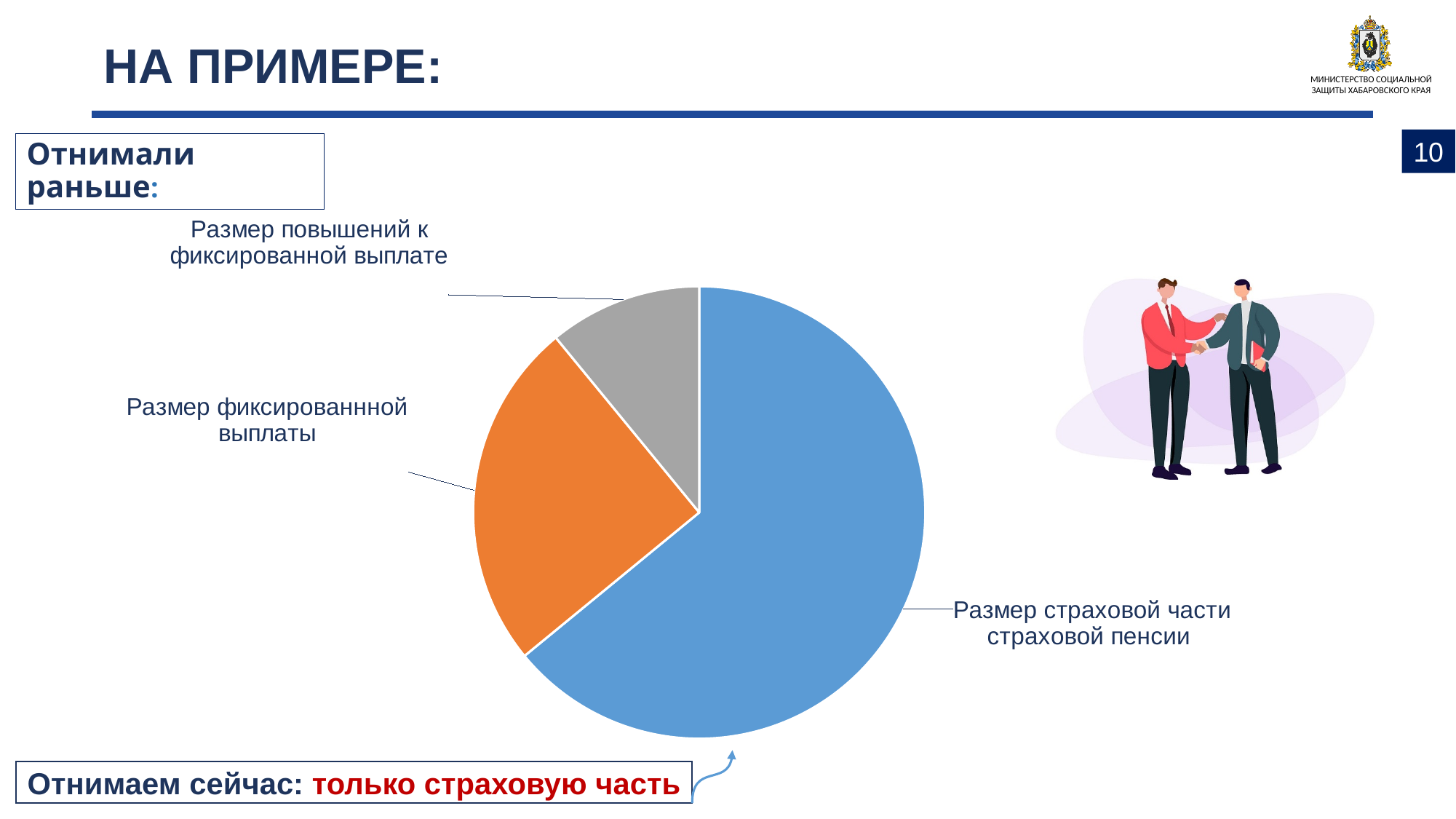
How many slices does the pie chart have? 3 What kind of chart is shown on the slide? pie chart Which slice of the pie chart is coloured orange? Размер фиксированнной выплаты What colour is the slice labelled "Размер страховой части страховой пенсии"? blue Which slice of the pie chart is the smallest? Размер повышений к фиксированной выплате Which slice is larger: "Размер страховой части страховой пенсии" or "Размер фиксированнной выплаты"? Размер страховой части страховой пенсии Which slice is larger: "Размер фиксированнной выплаты" or "Размер повышений к фиксированной выплате"? Размер фиксированнной выплаты Which slice of the pie chart is the largest? Размер страховой части страховой пенсии